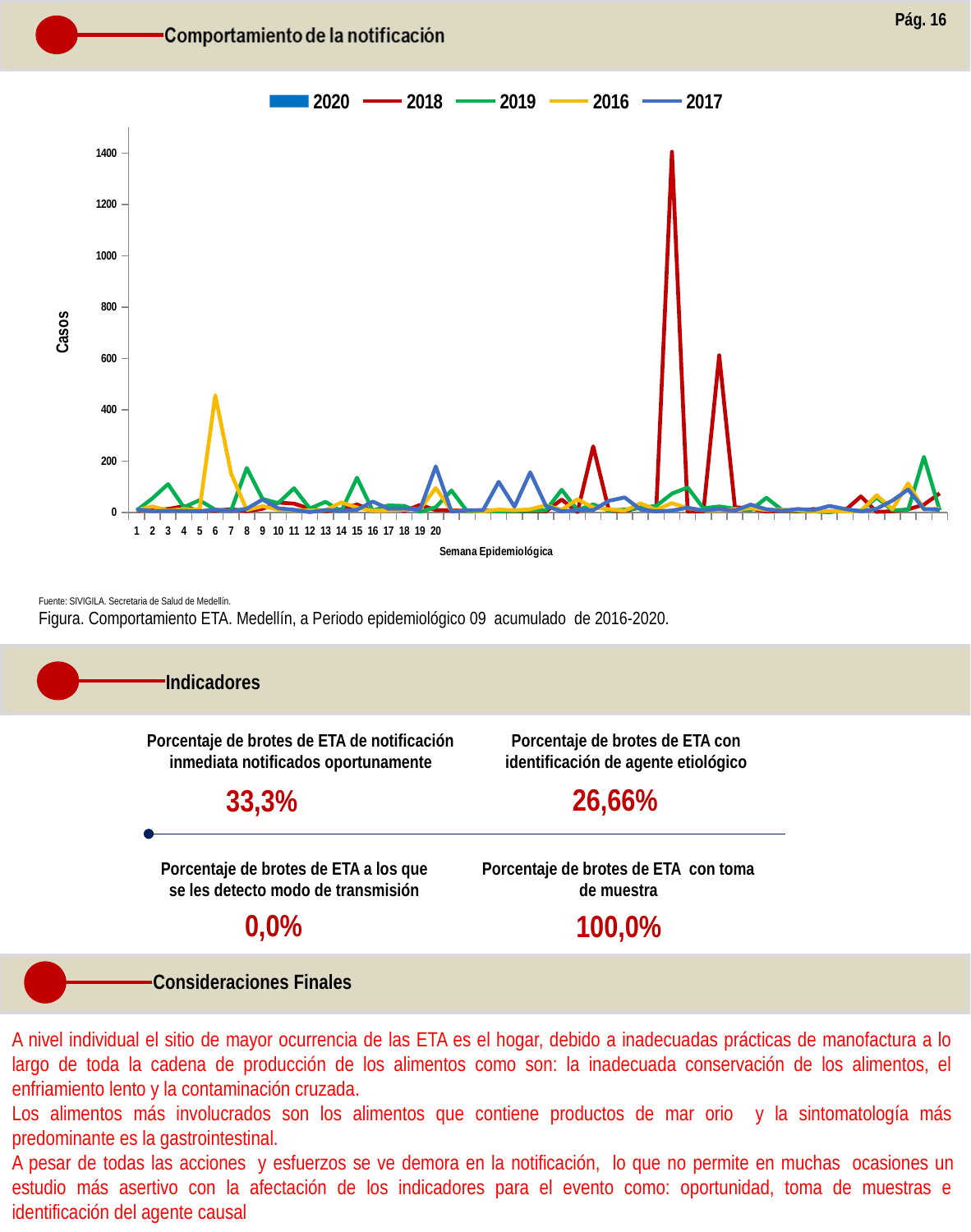
Is the highest peak of the 2018 series greater or less than 1200 cases? greater What is the highest value shown on the vertical axis of the chart? 1400 Is the value of the 2017 series at week 20 greater or less than 100 cases? greater What is the label of the horizontal axis of the chart? Semana Epidemiológica What kind of chart is shown on the slide? combination bar and line chart Is the peak of the 2016 series at week 6 greater or less than 400 cases? greater Which series has the higher value at week 6, 2016 or 2019? 2016 How many series does the chart legend list? 5 What is the label of the vertical axis of the chart? Casos Which series reaches the highest number of cases on the chart? 2018